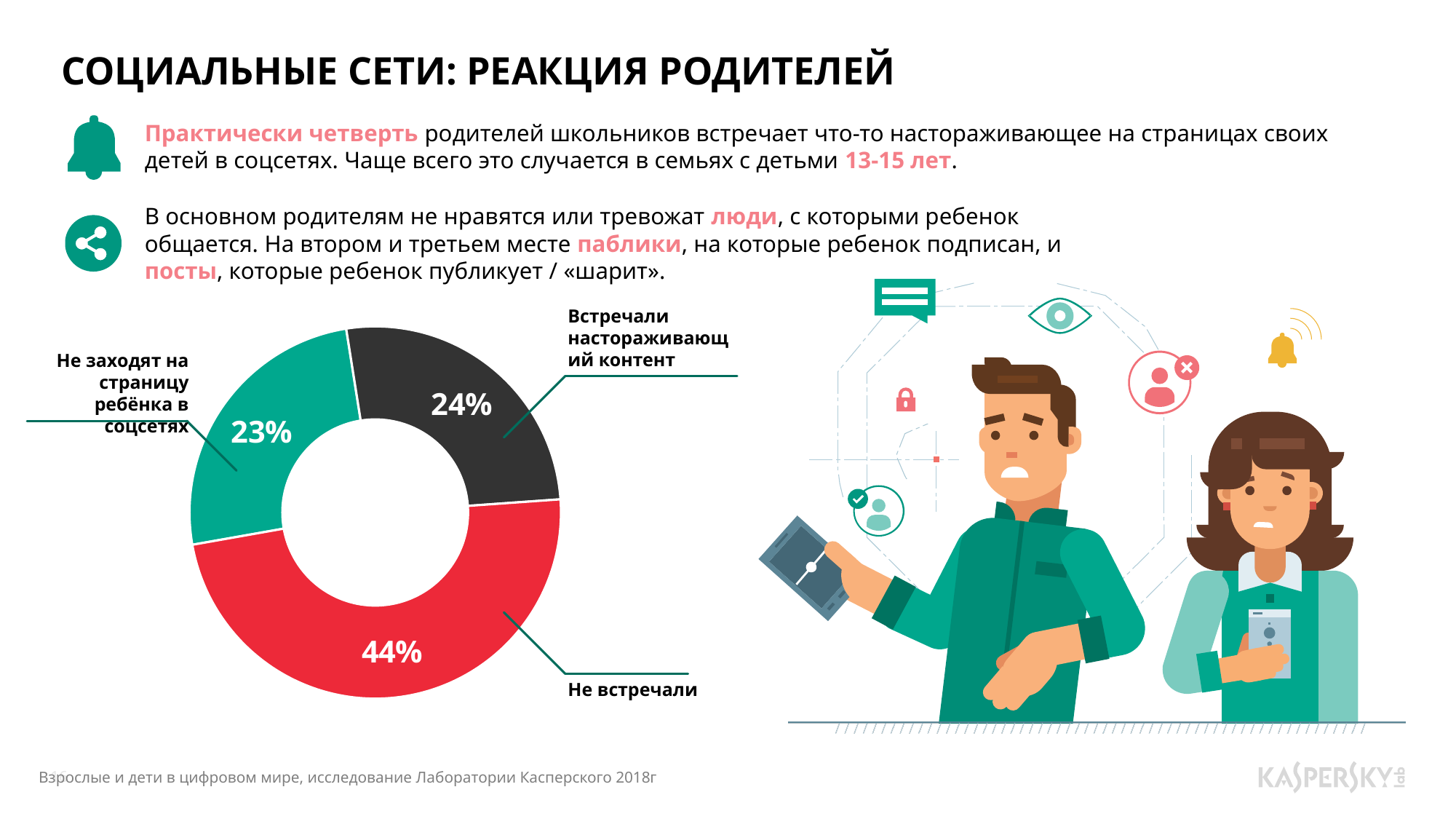
What percentage of parents "Не встречали" alarming content? 44% What is the difference in percentage points between "Встречали настораживающий контент" and "Не заходят на страницу ребёнка в соцсетях"? 1 What type of chart is shown on the slide? Donut (pie) chart What percentage of parents "Не заходят на страницу ребёнка в соцсетях"? 23% Which category has the largest share in the donut chart? Не встречали What percentage of parents "Встречали настораживающий контент"? 24% How many categories (slices) does the donut chart have? 3 What colour is the slice for "Не встречали"? Red What colour is the slice for "Встречали настораживающий контент"? Black Which category has the smallest share in the donut chart? Не заходят на страницу ребёнка в соцсетях What is the difference in percentage points between "Не встречали" and "Встречали настораживающий контент"? 20 Which is larger: the share for "Не встречали" or the share for "Не заходят на страницу ребёнка в соцсетях"? Не встречали